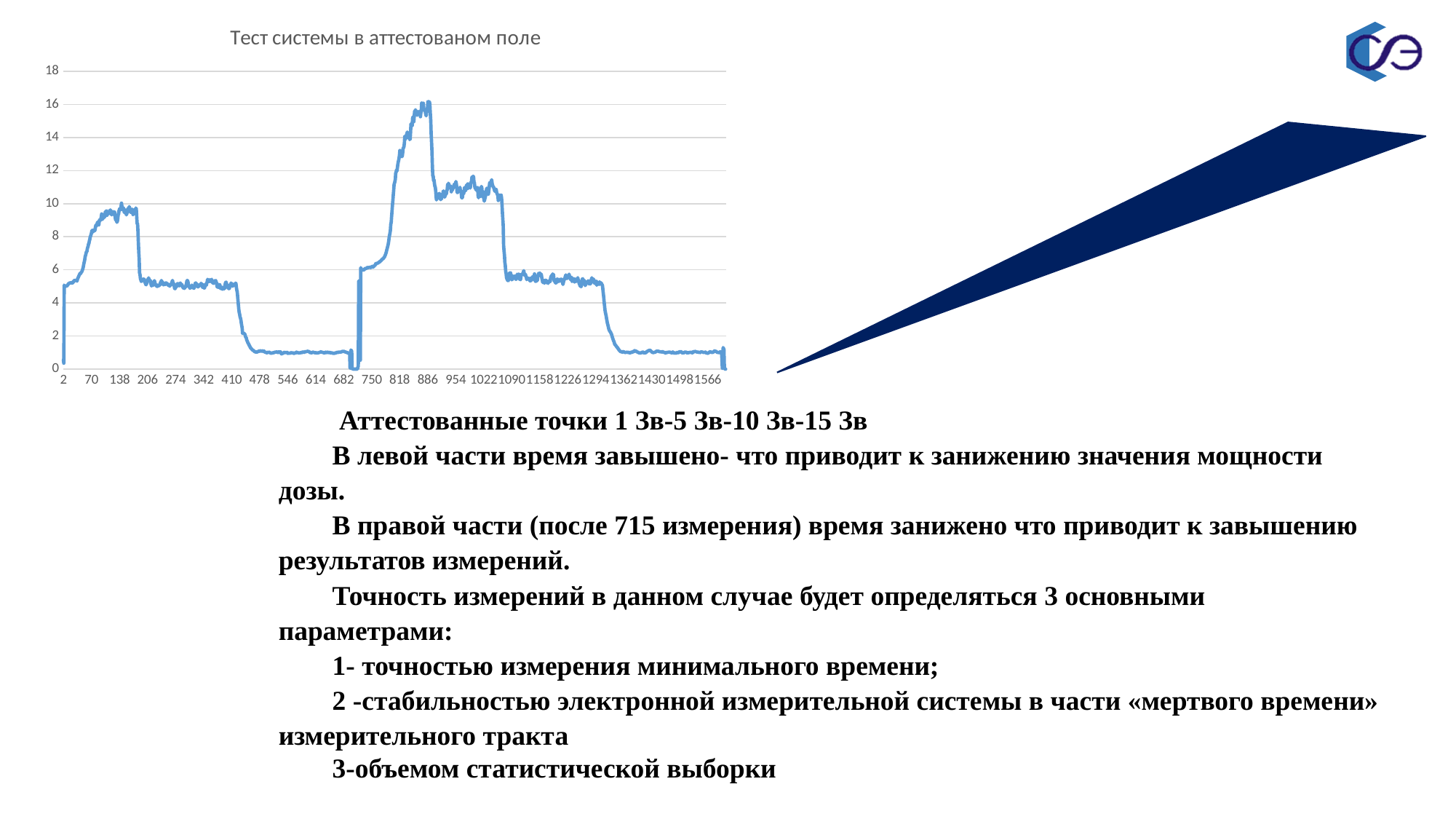
What kind of chart is shown on the slide? line chart Do the values rise or fall along the x axis between x = 2 and x = 138? rise Is the peak value of the line near x = 886 greater or less than 14? greater Which is larger: the value of the line near x = 886 or near x = 138? near x = 886 Is the value of the line near x = 138 greater or less than 8? greater What is the title of the chart? Тест системы в аттестованом поле Is the value of the line near x = 274 greater or less than 6? less Do the values rise or fall overall along the x axis between x = 886 and x = 1566? fall What is the highest value labelled on the vertical axis of the chart? 18